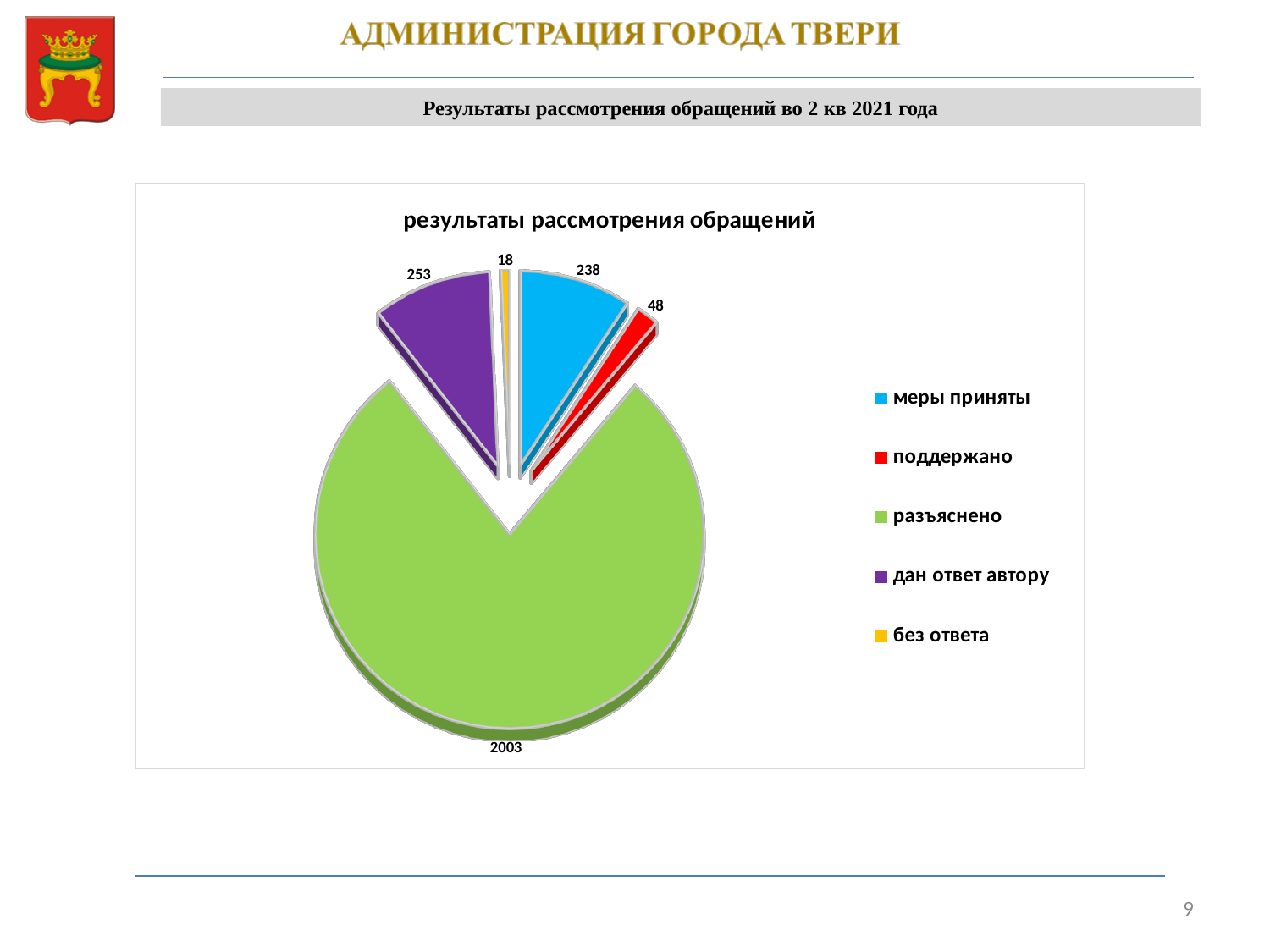
What is the title of the chart? результаты рассмотрения обращений Which category has the largest slice of the pie? разъяснено Which is larger: the value for 'поддержано' or the value for 'без ответа'? поддержано What is the value for the 'разъяснено' slice? 2003 What is the value for the 'поддержано' slice? 48 What is the difference between the values for 'дан ответ автору' and 'меры приняты'? 15 What is the value for the 'без ответа' slice? 18 How many categories does the legend list? 5 What kind of chart is shown on the slide? pie chart What is the value for the 'дан ответ автору' slice? 253 What is the value for the 'меры приняты' slice? 238 Which category has the smallest slice of the pie? без ответа